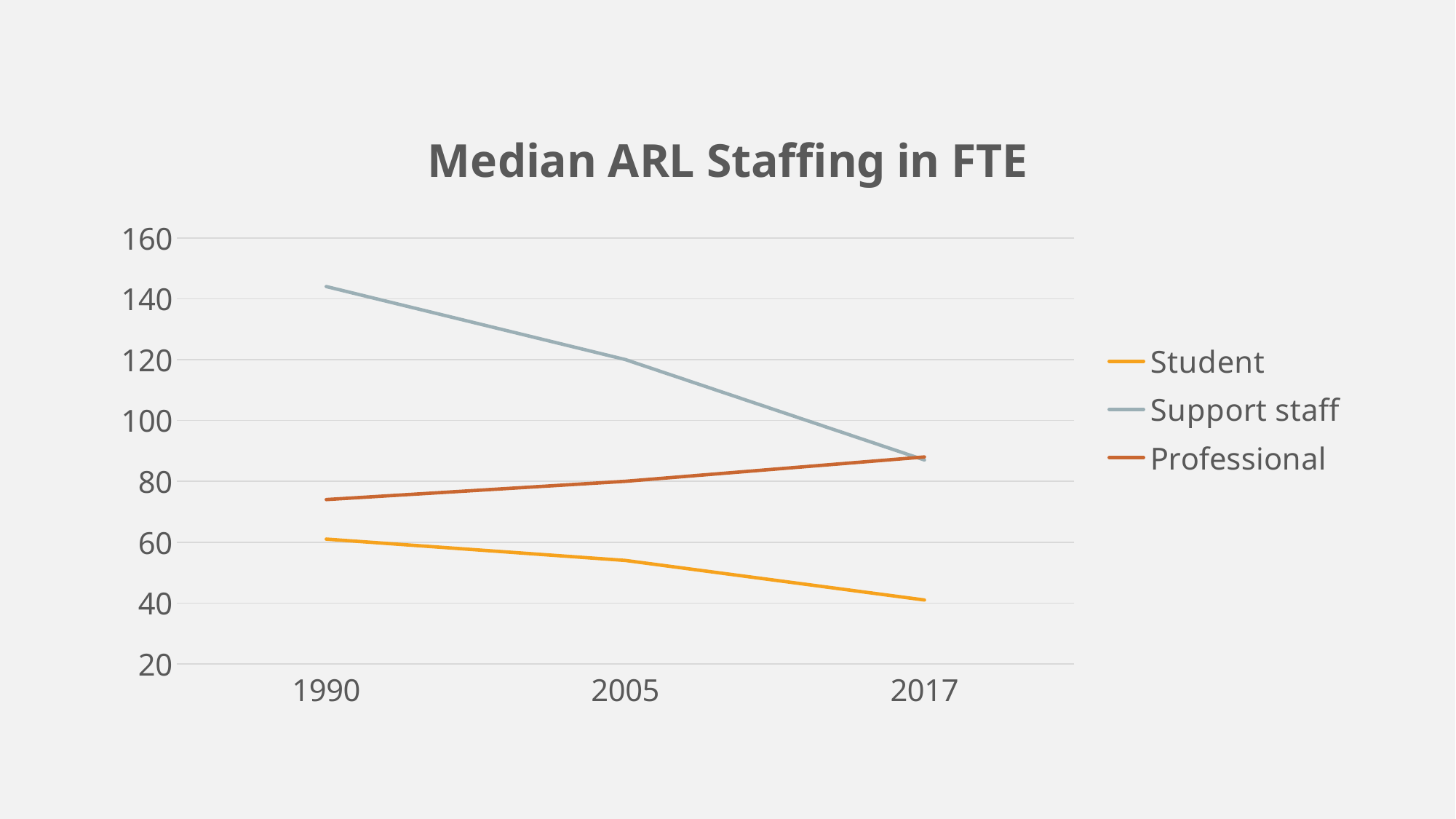
Which series has the lowest value in 2005? Student How many years are shown on the x axis? 3 Does the Professional line rise or fall from 1990 to 2017? rise Is the value for Support staff in 1990 greater or less than 120? greater Is the value for Student in 2017 greater or less than 60? less What kind of chart is shown on the slide? line chart Which series has the highest value in 1990? Support staff Is the value for Professional in 1990 greater or less than 80? less In 2005, which is larger: the value for Professional or the value for Student? Professional Does the Support staff line rise or fall from 1990 to 2017? fall What is the title of the chart? Median ARL Staffing in FTE How many series does the legend list? 3